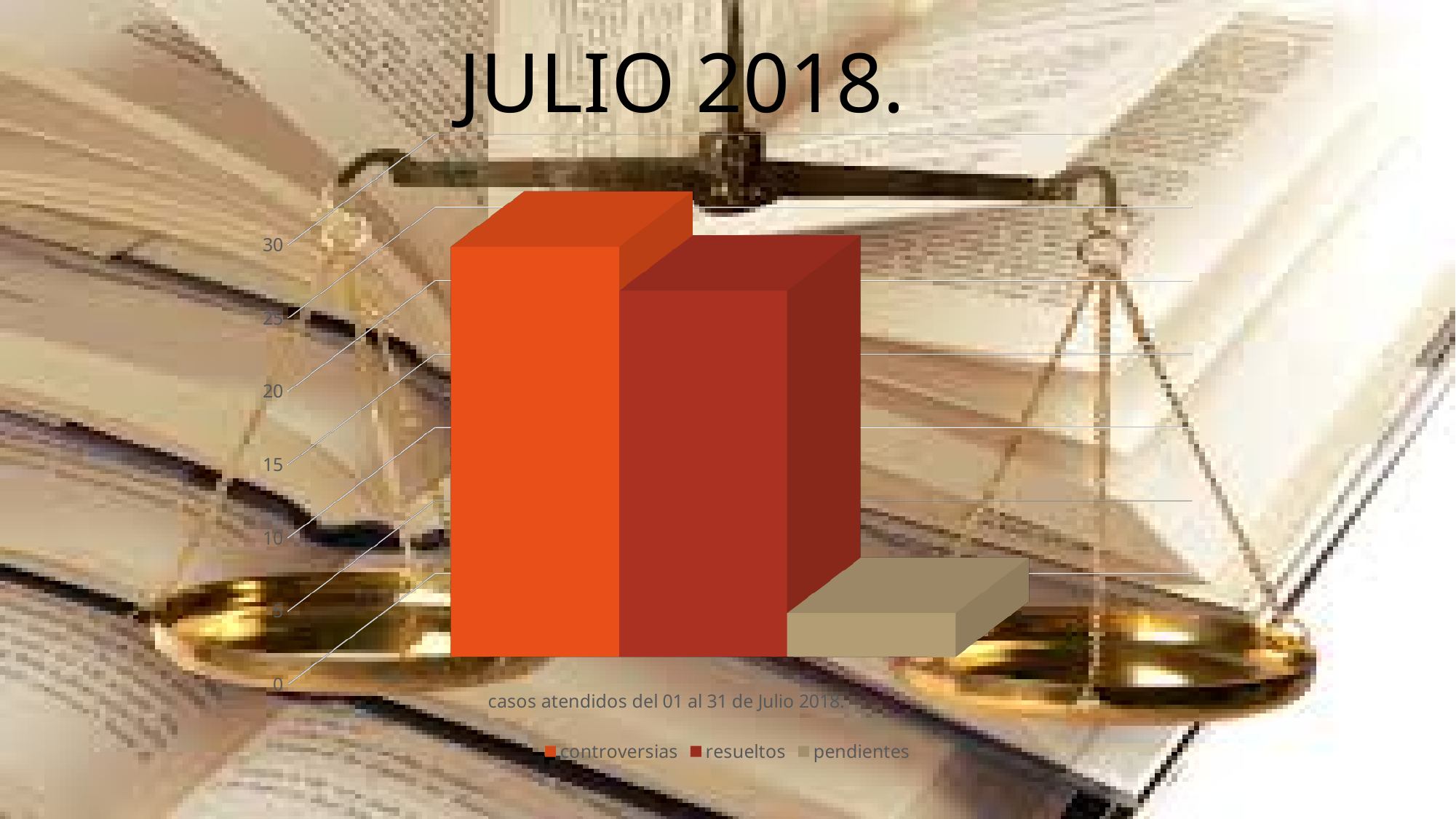
What are the series names listed in the chart legend? controversias, resueltos, pendientes What kind of chart is shown on the slide? bar chart Which series has the lowest value in the chart? pendientes How many series does the chart legend list? 3 Which series has the highest value in the chart? controversias Is the value for pendientes greater or less than 10? less What is the category label shown on the x axis of the chart? casos atendidos del 01 al 31 de Julio 2018. Which is larger, the value for resueltos or the value for pendientes? resueltos Is the value for resueltos greater or less than 15? greater How many categories are shown on the x axis of the chart? 1 Is the value for controversias greater or less than 20? greater Which is larger, the value for controversias or the value for resueltos? controversias